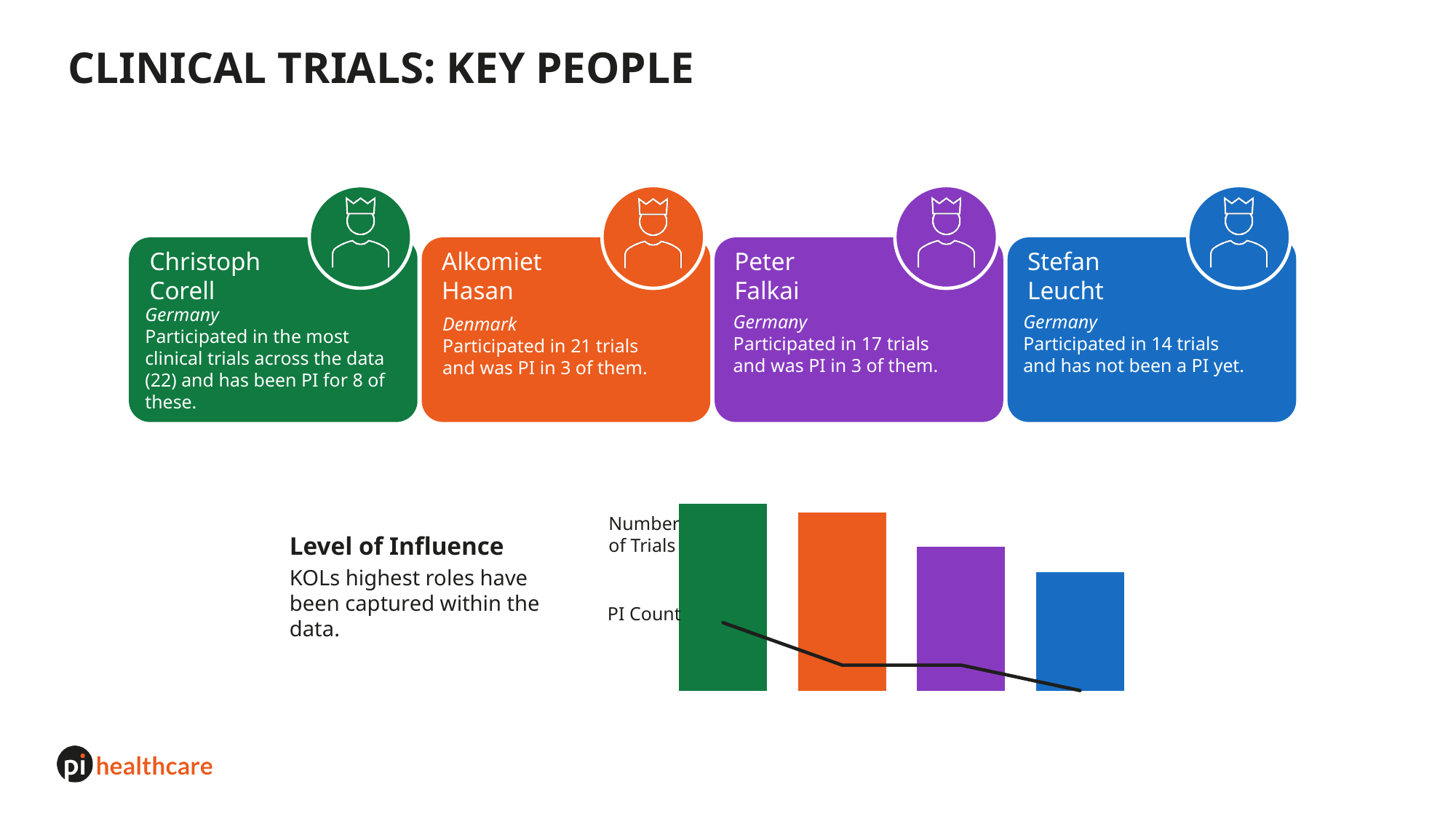
Does the PI Count line rise or fall from left to right? fall What colour is the tallest bar on the chart? green Which bar is the shortest in the Number of Trials chart? the blue bar (Stefan Leucht) According to the slide, how many trials does the blue bar (Stefan Leucht) represent? 14 What does the black line on the chart represent? PI Count How many series are labelled on the chart (Number of Trials and PI Count)? 2 Which is taller, the orange bar or the purple bar? the orange bar Which bar is the tallest in the Number of Trials chart? the green bar (Christoph Corell) Do the bars for Number of Trials rise or fall from left to right? fall According to the slide, how many clinical trials does the green bar (Christoph Corell) represent? 22 What kind of chart is shown at the bottom of the slide? combination bar and line chart How many bars does the chart at the bottom of the slide have? 4